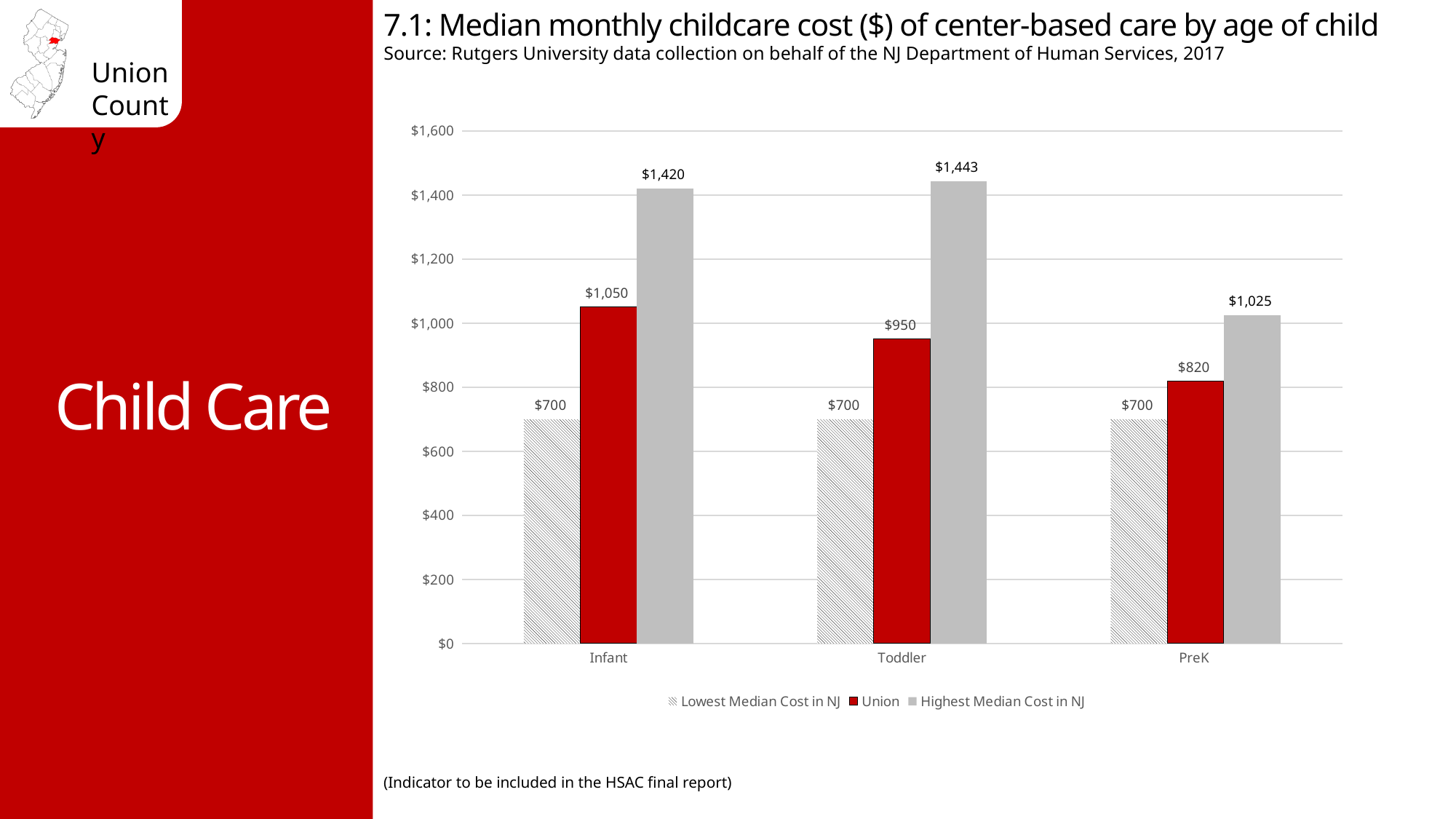
Do the Union values rise or fall from Infant to PreK? Fall How many series does the legend list? 3 What kind of chart is shown on the slide? Bar chart What is the median monthly childcare cost for Union for Infant care? $1,050 What is the Highest Median Cost in NJ for Toddler care? $1,443 What is the difference between the Highest Median Cost in NJ and the Union cost for Infant care? $370 What is the difference between the Union cost for Toddler care and the Union cost for PreK care? $130 Which age group has the lowest Highest Median Cost in NJ? PreK What is the Lowest Median Cost in NJ for PreK care? $700 Which is larger: the Union cost for Toddler care or the Union cost for PreK care? Union cost for Toddler care Which age group has the highest Union median monthly cost? Infant How many age groups are shown on the x axis? 3